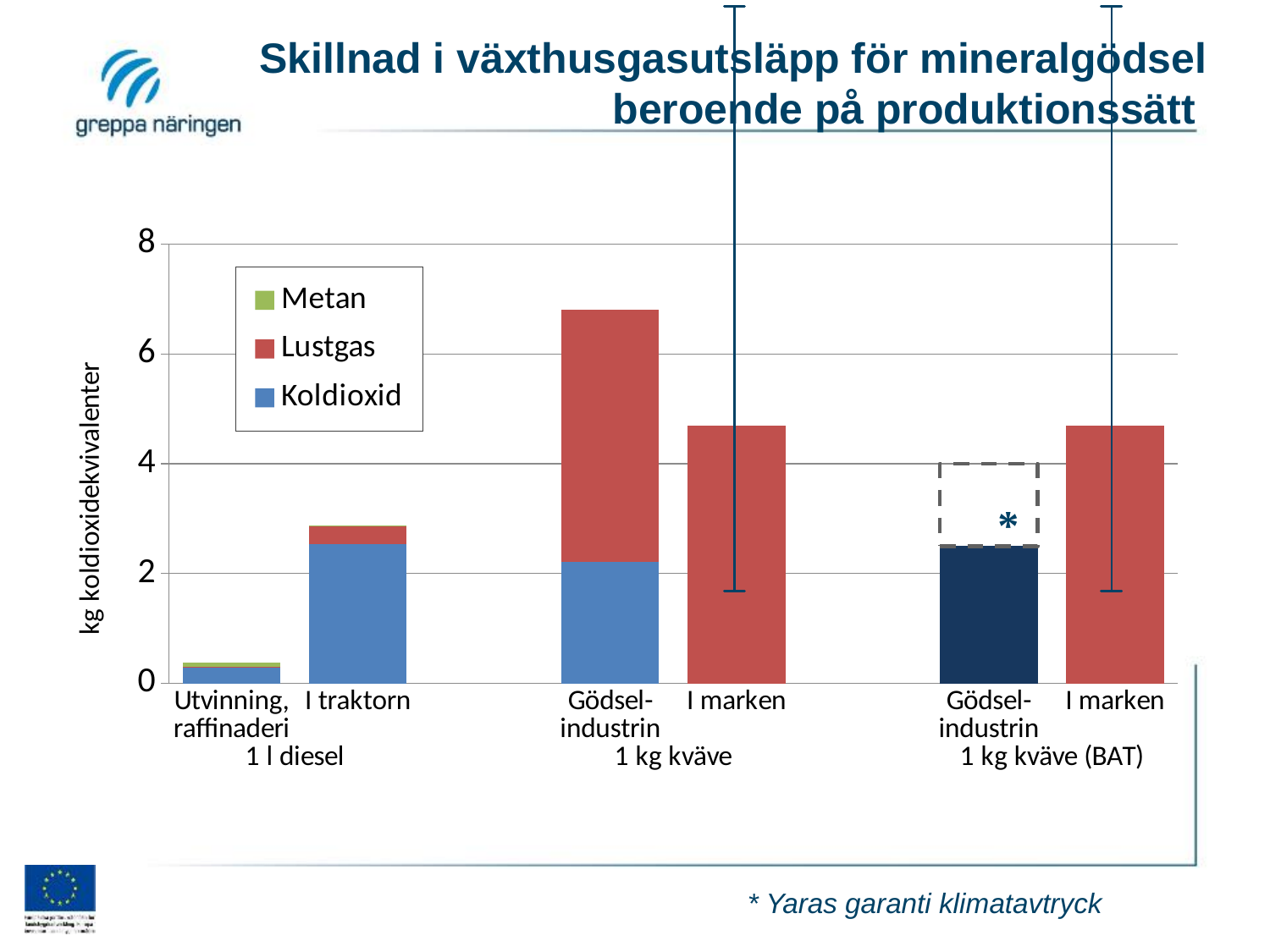
Is the total value for I traktorn greater or less than 2? greater Which bar is the highest in the chart? Gödsel-industrin (1 kg kväve) Is the value for Utvinning, raffinaderi greater or less than 2? less How many series does the legend list? 3 How many bars are plotted in the chart? 6 Which is larger: the bar for I traktorn or the bar for Gödsel-industrin under 1 kg kväve? Gödsel-industrin (1 kg kväve) What kind of chart is shown on the slide? bar chart What is the label on the vertical axis? kg koldioxidekvivalenter Which colour represents Lustgas in the legend? red Which bar is the lowest in the chart? Utvinning, raffinaderi Is the total value for Gödsel-industrin under 1 kg kväve greater or less than 6? greater